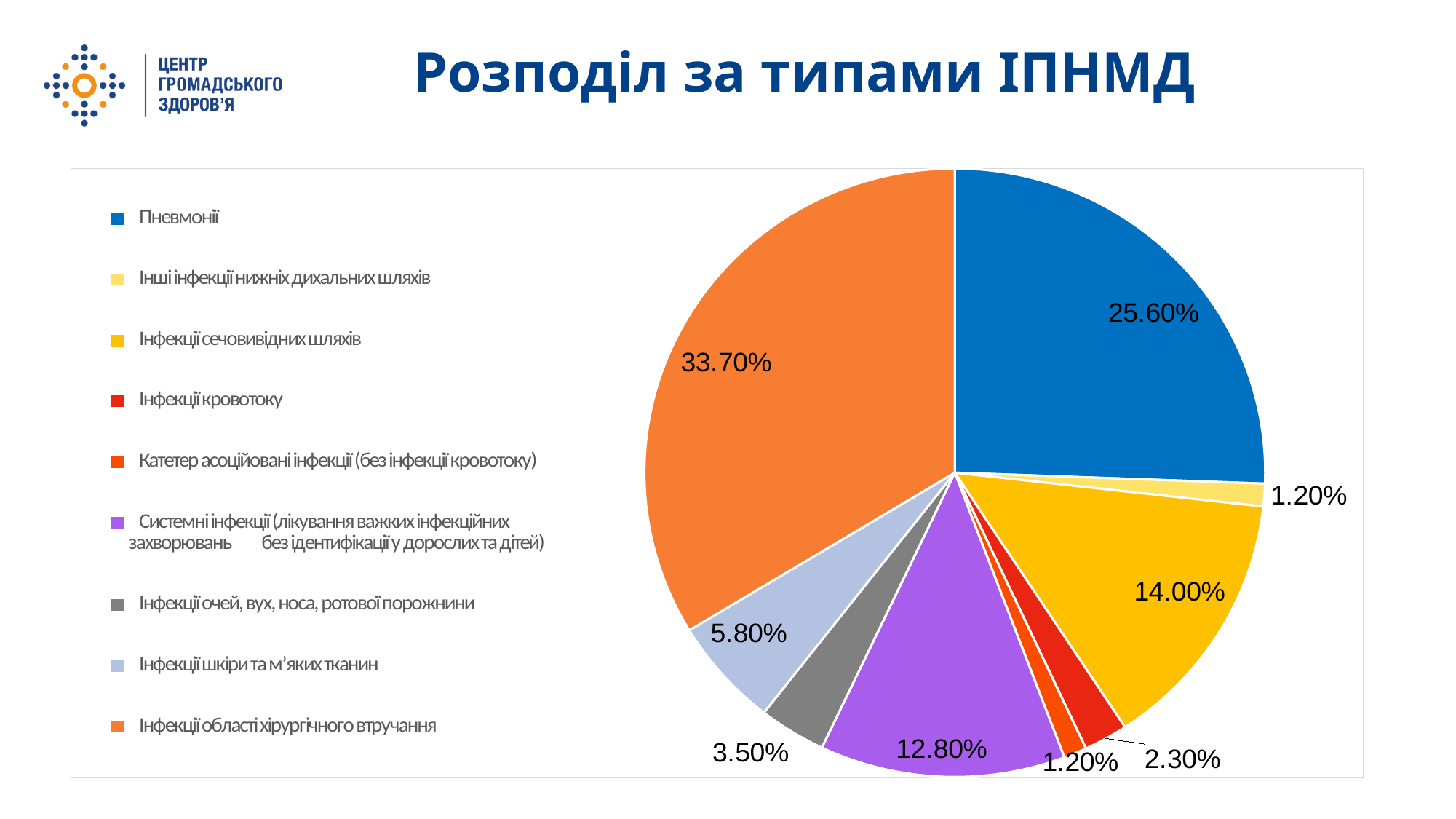
What share of the pie is labelled for Пневмонії? 25.60% What colour is the slice for Системні інфекції? purple What share of the pie is labelled for Інфекції сечовивідних шляхів? 14.00% How many categories does the legend list? 9 Which is larger: the share for Системні інфекції or the share for Інфекції сечовивідних шляхів? Інфекції сечовивідних шляхів Which category has the largest slice of the pie? Інфекції області хірургічного втручання What share of the pie is labelled for Інфекції кровотоку? 2.30% What is the title of the chart on the slide? Розподіл за типами ІПНМД What kind of chart is shown on the slide? pie chart What share of the pie is labelled for Інфекції області хірургічного втручання? 33.70% What share of the pie is labelled for Інфекції шкіри та м'яких тканин? 5.80% What is the difference between the shares for Інфекції області хірургічного втручання and Пневмонії? 8.10%